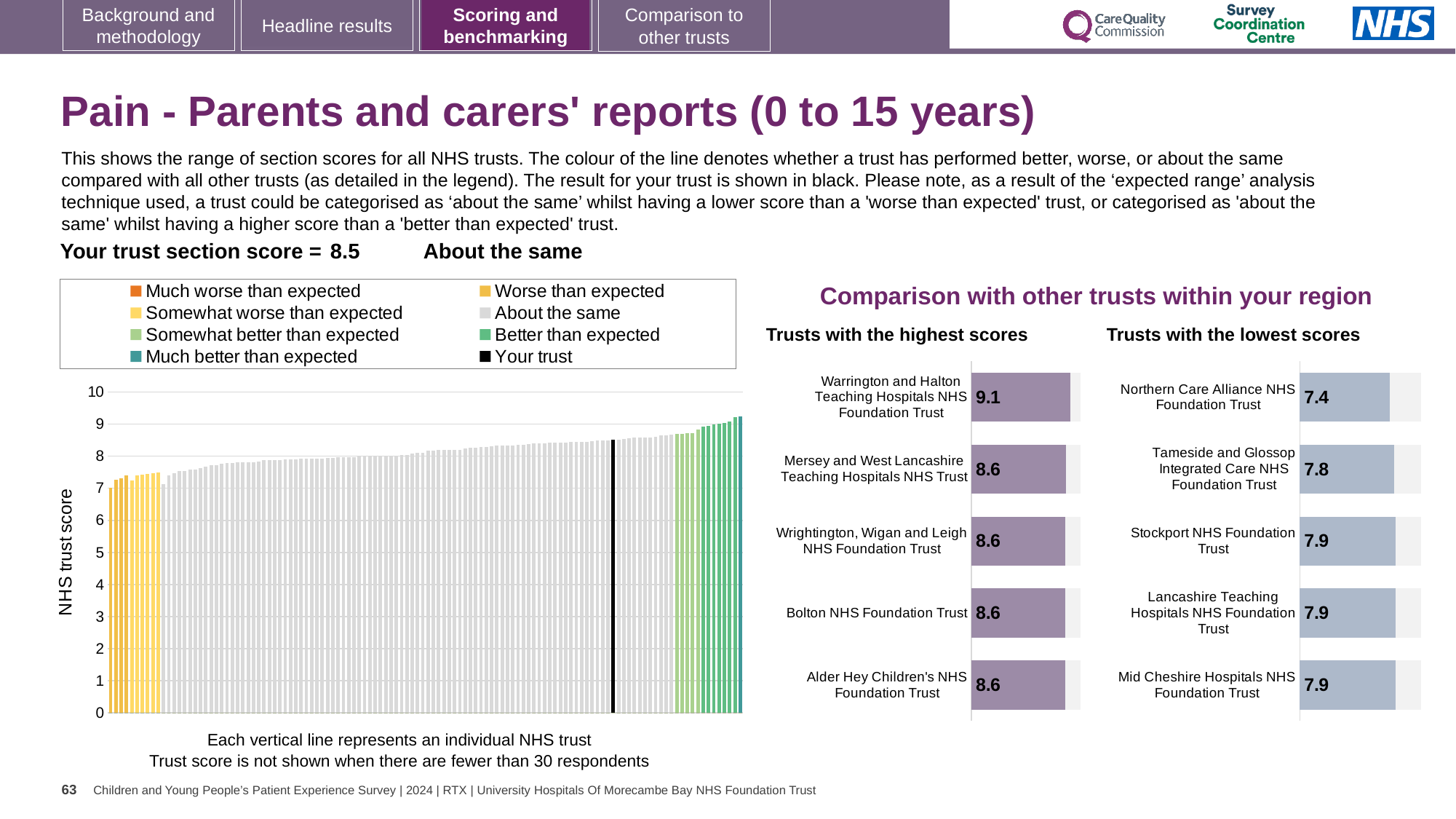
In the 'Trusts with the highest scores' chart, which trust has the highest score? Warrington and Halton Teaching Hospitals NHS Foundation Trust In the 'Trusts with the highest scores' chart, what is the difference between the scores of Warrington and Halton Teaching Hospitals NHS Foundation Trust and Bolton NHS Foundation Trust? 0.5 In the 'Trusts with the lowest scores' chart, what is the score for Tameside and Glossop Integrated Care NHS Foundation Trust? 7.8 In the 'Trusts with the highest scores' chart, what is the score for Warrington and Halton Teaching Hospitals NHS Foundation Trust? 9.1 What kind of chart is the main chart on the left with the 'NHS trust score' axis? Bar chart In the 'Trusts with the lowest scores' chart, what is the score for Northern Care Alliance NHS Foundation Trust? 7.4 In the main 'NHS trust score' chart, is the value of the tallest bar greater or less than 10? less In the 'Trusts with the lowest scores' chart, which has the larger score: Tameside and Glossop Integrated Care NHS Foundation Trust or Stockport NHS Foundation Trust? Stockport NHS Foundation Trust How many entries does the legend of the main 'NHS trust score' chart list? 8 In the 'Trusts with the lowest scores' chart, which trust has the lowest score? Northern Care Alliance NHS Foundation Trust How many trusts are shown in the 'Trusts with the lowest scores' chart? 5 In the main 'NHS trust score' chart, do the bar values rise or fall from left to right? Rise